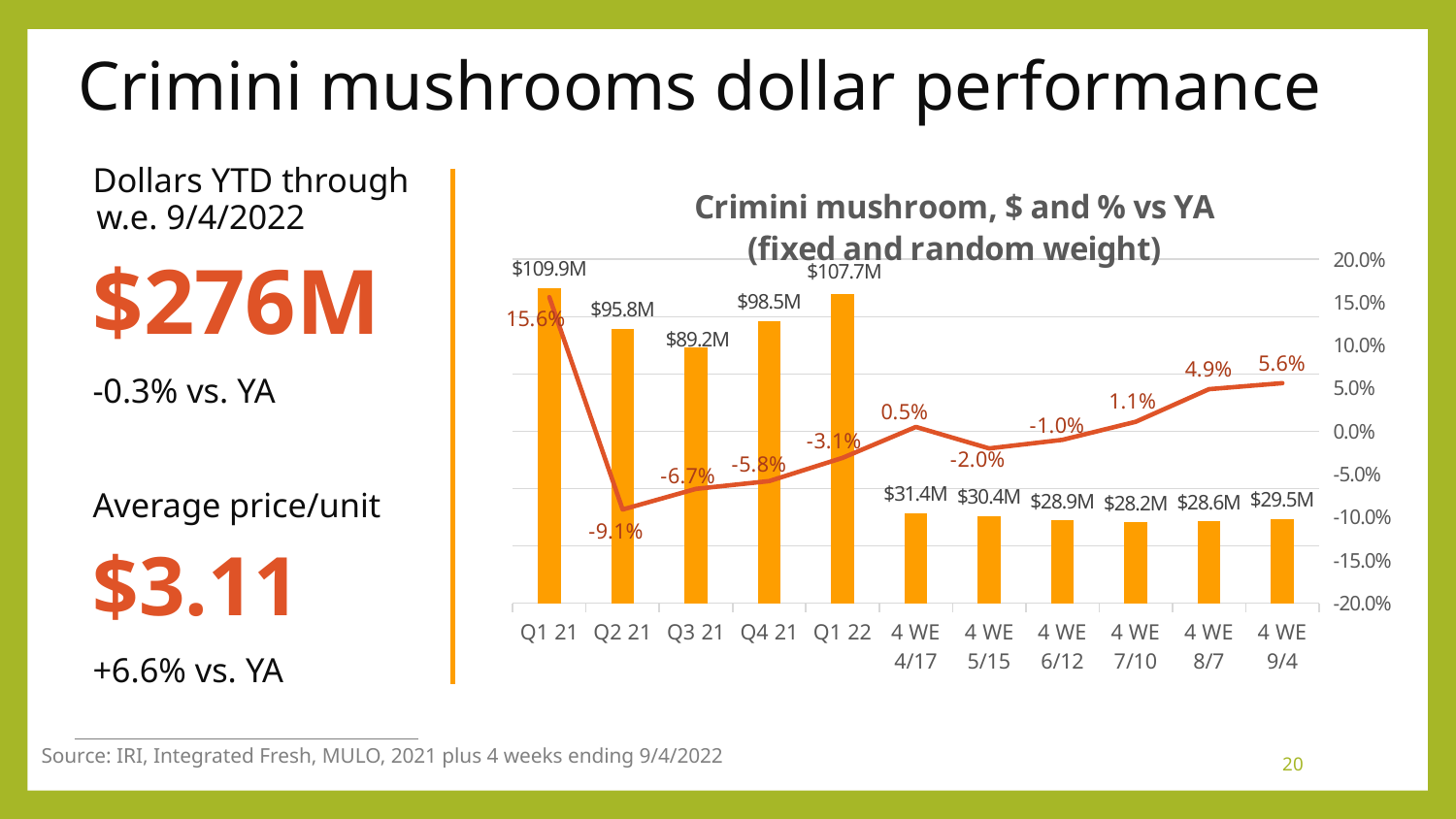
What kind of chart is this? Combination bar and line chart What is the title of the chart? Crimini mushroom, $ and % vs YA (fixed and random weight) What is the dollar value shown for Q1 21? $109.9M What is the dollar value shown for 4 WE 4/17? $31.4M What is the % vs YA value shown for 4 WE 9/4? 5.6% Does the % vs YA line rise or fall from 4 WE 6/12 to 4 WE 9/4? Rise What is the difference in dollar value between Q1 21 and Q1 22? $2.2M Which period has the highest dollar value bar? Q1 21 How many periods are shown on the x axis? 11 Which period has the lowest dollar value bar? 4 WE 7/10 Which period has the lowest % vs YA value on the line? Q2 21 Which has the larger dollar value, Q4 21 or Q2 21? Q4 21